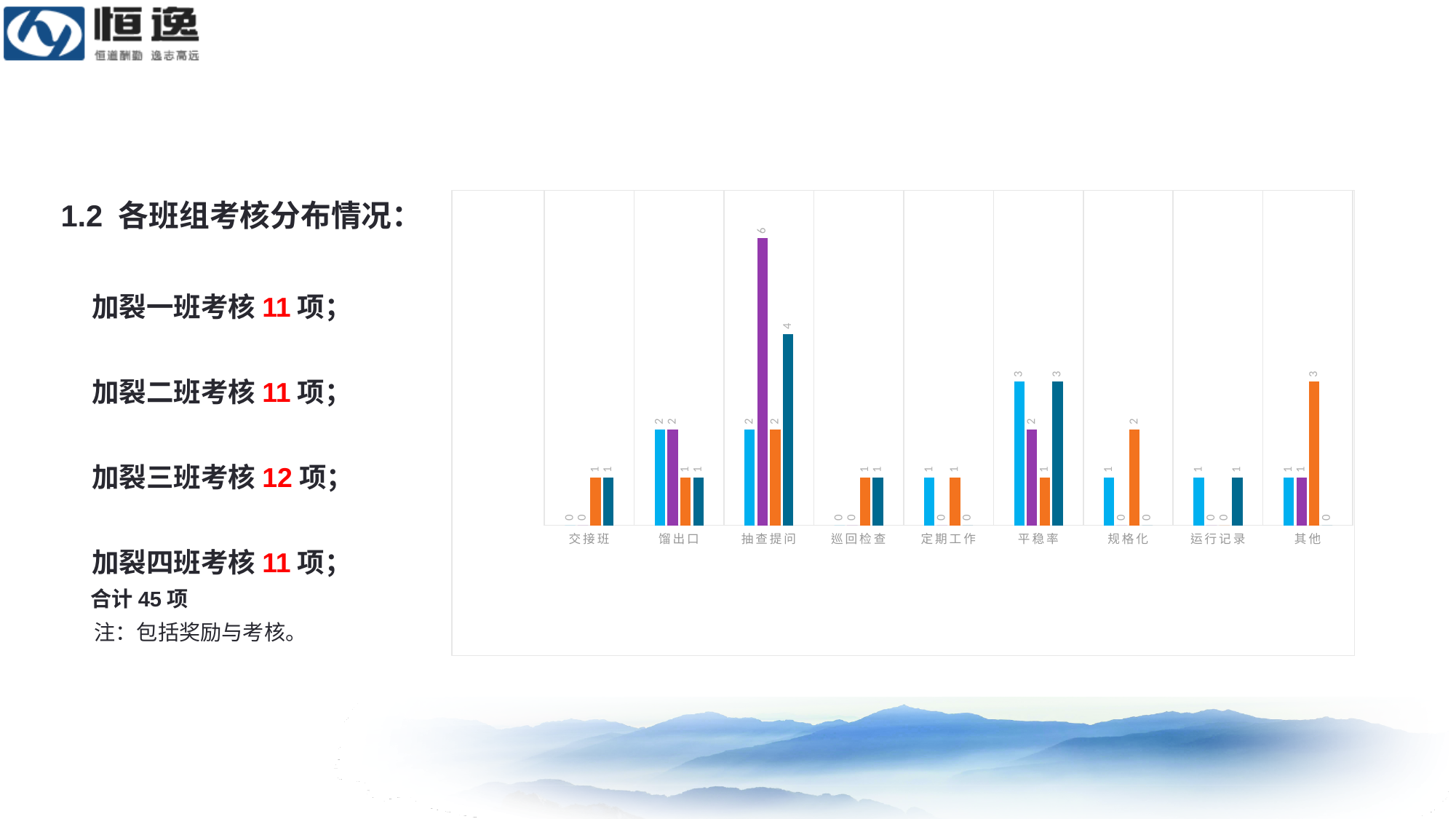
What is the value of the purple bar for 抽查提问? 6 What is the difference between the orange bar for 其他 and the orange bar for 平稳率? 2 What kind of chart is shown on the slide? bar chart Which is larger for 规格化: the light blue bar or the orange bar? the orange bar What is the value of the light blue bar for 平稳率? 3 What is the value of the orange bar for 规格化? 2 What is the value of the orange bar for 其他? 3 What is the value of the dark teal bar for 抽查提问? 4 How many differently coloured bar series are plotted for each category? 4 Which category has the tallest bar in the chart? 抽查提问 What is the difference between the purple bar and the dark teal bar for 抽查提问? 2 How many categories are shown along the x axis of the chart? 9